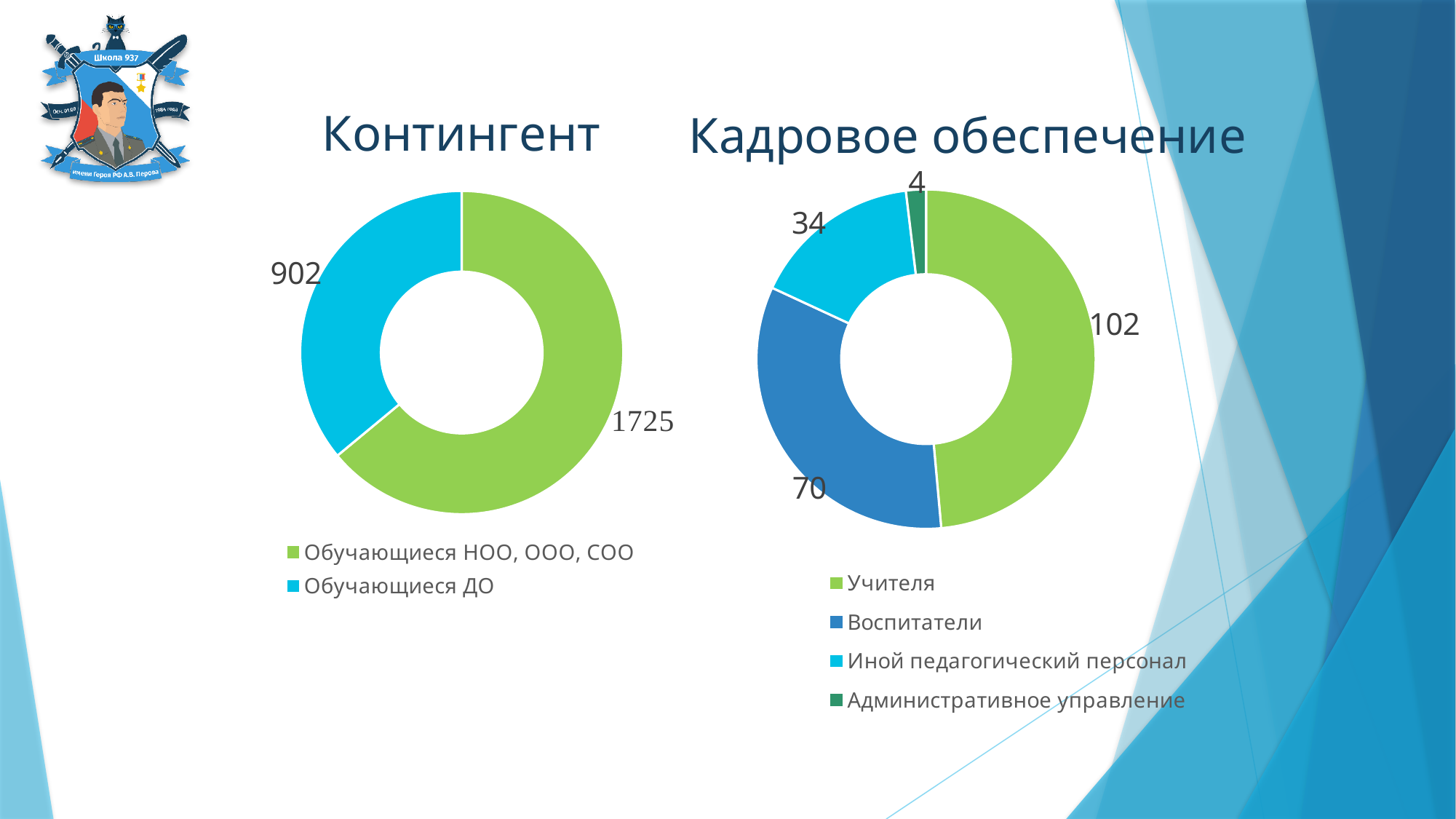
In the "Контингент" chart, what is the value for Обучающиеся ДО? 902 In the "Кадровое обеспечение" chart, which category has the smallest value? Административное управление In the "Контингент" chart, what is the value for Обучающиеся НОО, ООО, СОО? 1725 What type of chart is the "Контингент" chart? Doughnut chart In the "Кадровое обеспечение" chart, which category has the largest value? Учителя In the "Кадровое обеспечение" chart, what is the value for Иной педагогический персонал? 34 In the "Кадровое обеспечение" chart, what is the difference between Учителя and Воспитатели? 32 How many categories does the legend of the "Кадровое обеспечение" chart list? 4 In the "Контингент" chart, which segment is larger: Обучающиеся ДО or Обучающиеся НОО, ООО, СОО? Обучающиеся НОО, ООО, СОО In the "Кадровое обеспечение" chart, what is the value for Воспитатели? 70 In the "Кадровое обеспечение" chart, what is the total of all four segments? 210 In the "Контингент" chart, what is the difference between the two segments? 823